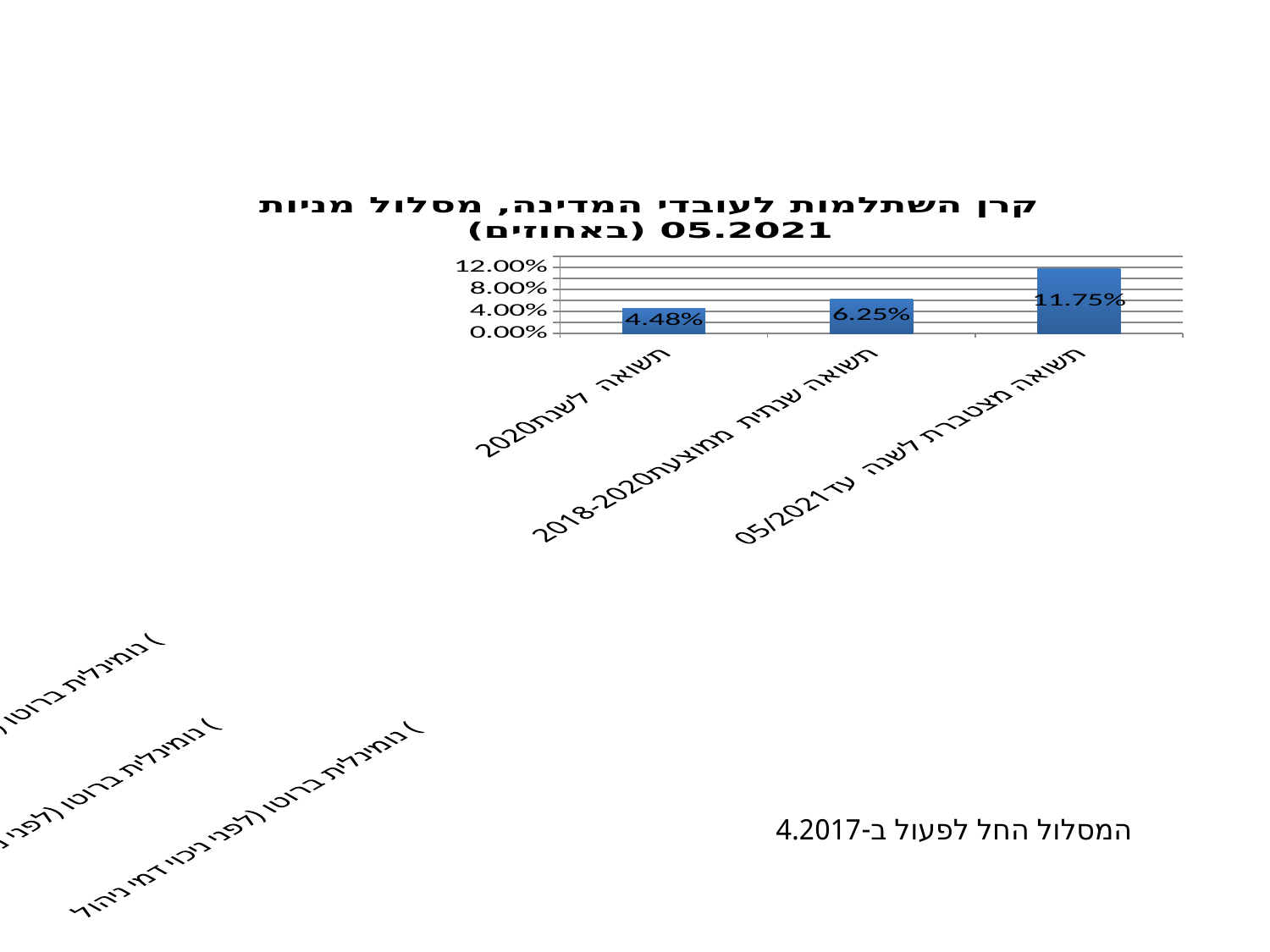
Do the values rise or fall from left to right along the x axis? rise What is the difference between the value for "תשואה מצטברת לשנה עד 05/2021" and the value for "תשואה לשנת 2020"? 7.27% How many categories are shown in the chart? 3 Which is larger: the value for "תשואה שנתית ממוצעת 2018-2020" or the value for "תשואה לשנת 2020"? תשואה שנתית ממוצעת 2018-2020 What is the value for "תשואה שנתית ממוצעת 2018-2020"? 6.25% Which category has the highest value? תשואה מצטברת לשנה עד 05/2021 Which category has the lowest value? תשואה לשנת 2020 What is the difference between the value for "תשואה שנתית ממוצעת 2018-2020" and the value for "תשואה לשנת 2020"? 1.77% Is the value for "תשואה מצטברת לשנה עד 05/2021" greater or less than 8.00%? greater What is the value for "תשואה לשנת 2020"? 4.48% What kind of chart is shown on the slide? bar chart What is the value for "תשואה מצטברת לשנה עד 05/2021"? 11.75%